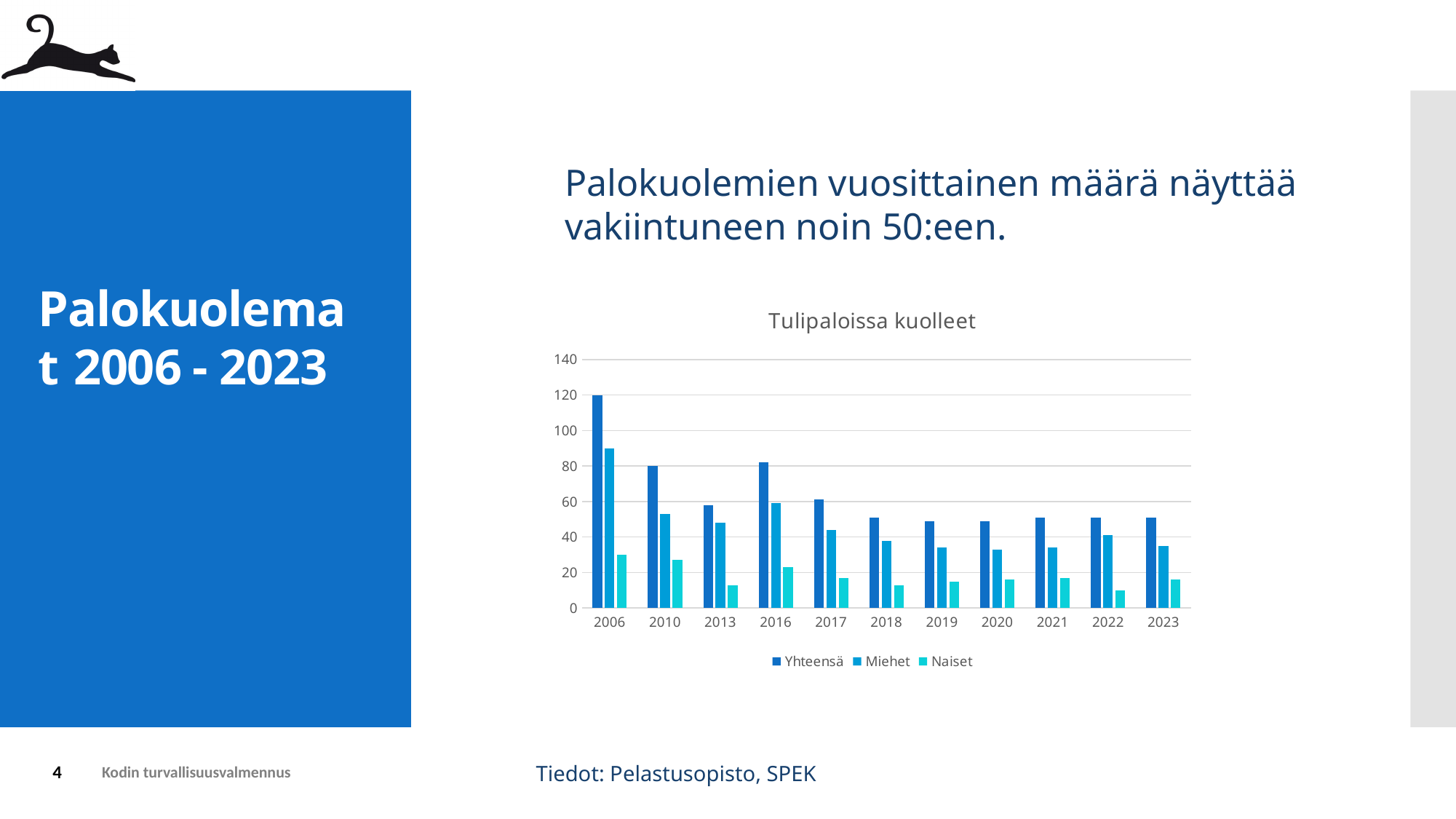
What kind of chart is shown on the slide? bar chart Is the Naiset value for 2013 greater or less than 20? less In which year is the Yhteensä value highest? 2006 How many years are shown on the x axis of the chart? 11 How many series does the legend list? 3 In which year is the Naiset value lowest? 2022 Which is larger, the Miehet value for 2006 or the Miehet value for 2010? 2006 What is the title of the chart? Tulipaloissa kuolleet In which year is the Naiset value highest? 2006 Is the Yhteensä value for 2006 greater or less than 100? greater Is the Miehet value for 2023 greater or less than 40? less Does the Yhteensä series generally rise or fall from 2006 to 2023? fall